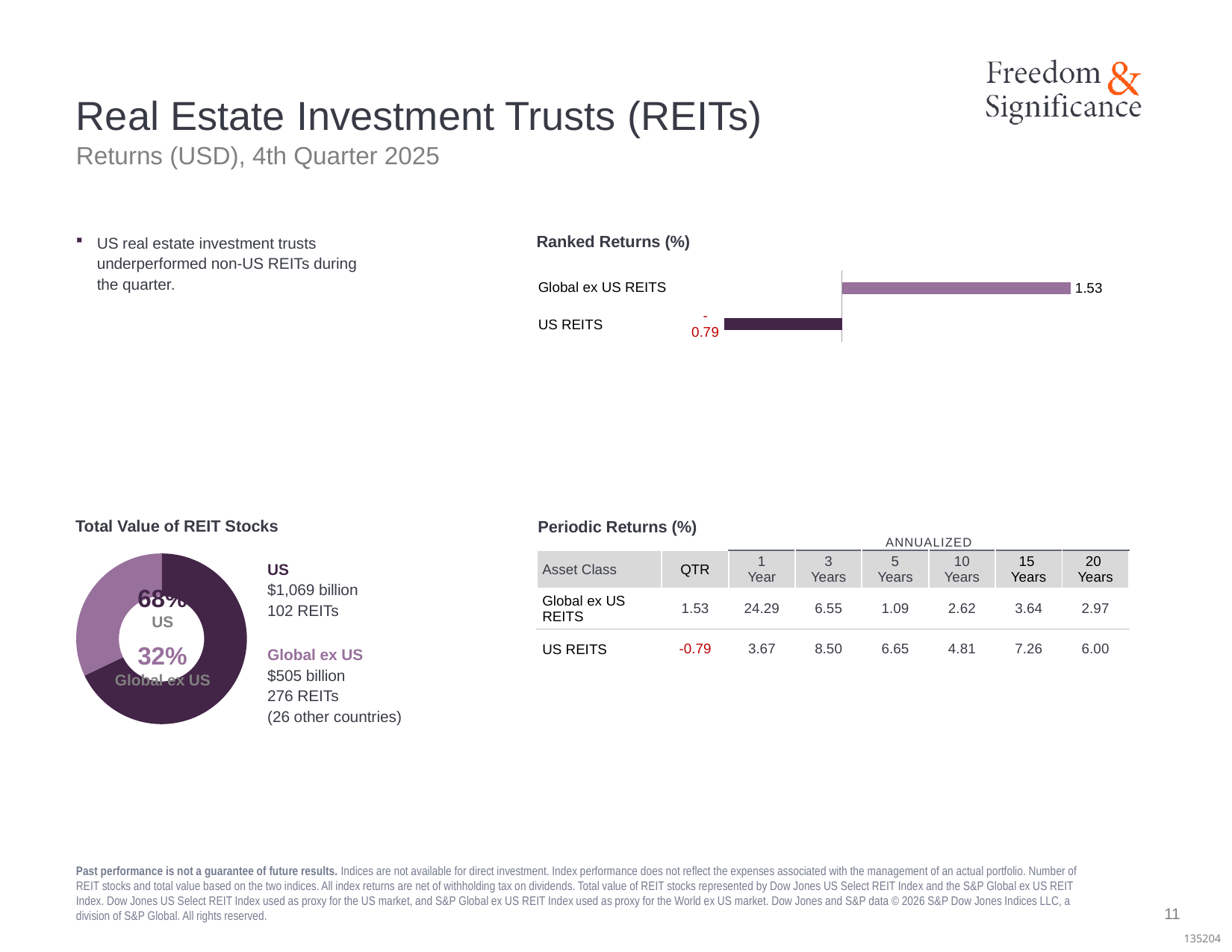
What kind of chart is the Total Value of REIT Stocks chart? Doughnut chart In the Ranked Returns (%) chart, what is the value for Global ex US REITS? 1.53 In the Ranked Returns (%) chart, what is the value for US REITS? -0.79 In the Total Value of REIT Stocks chart, which segment is larger, US or Global ex US? US How many categories are shown in the Ranked Returns (%) chart? 2 In the Ranked Returns (%) chart, which is larger, the value for Global ex US REITS or US REITS? Global ex US REITS What kind of chart is the Ranked Returns (%) chart? Bar chart In the Total Value of REIT Stocks chart, what share does US represent? 68% In the Total Value of REIT Stocks chart, what share does Global ex US represent? 32% In the Ranked Returns (%) chart, which category has the lowest return? US REITS In the Ranked Returns (%) chart, which category has the highest return? Global ex US REITS In the Ranked Returns (%) chart, what is the difference between the Global ex US REITS and US REITS values? 2.32